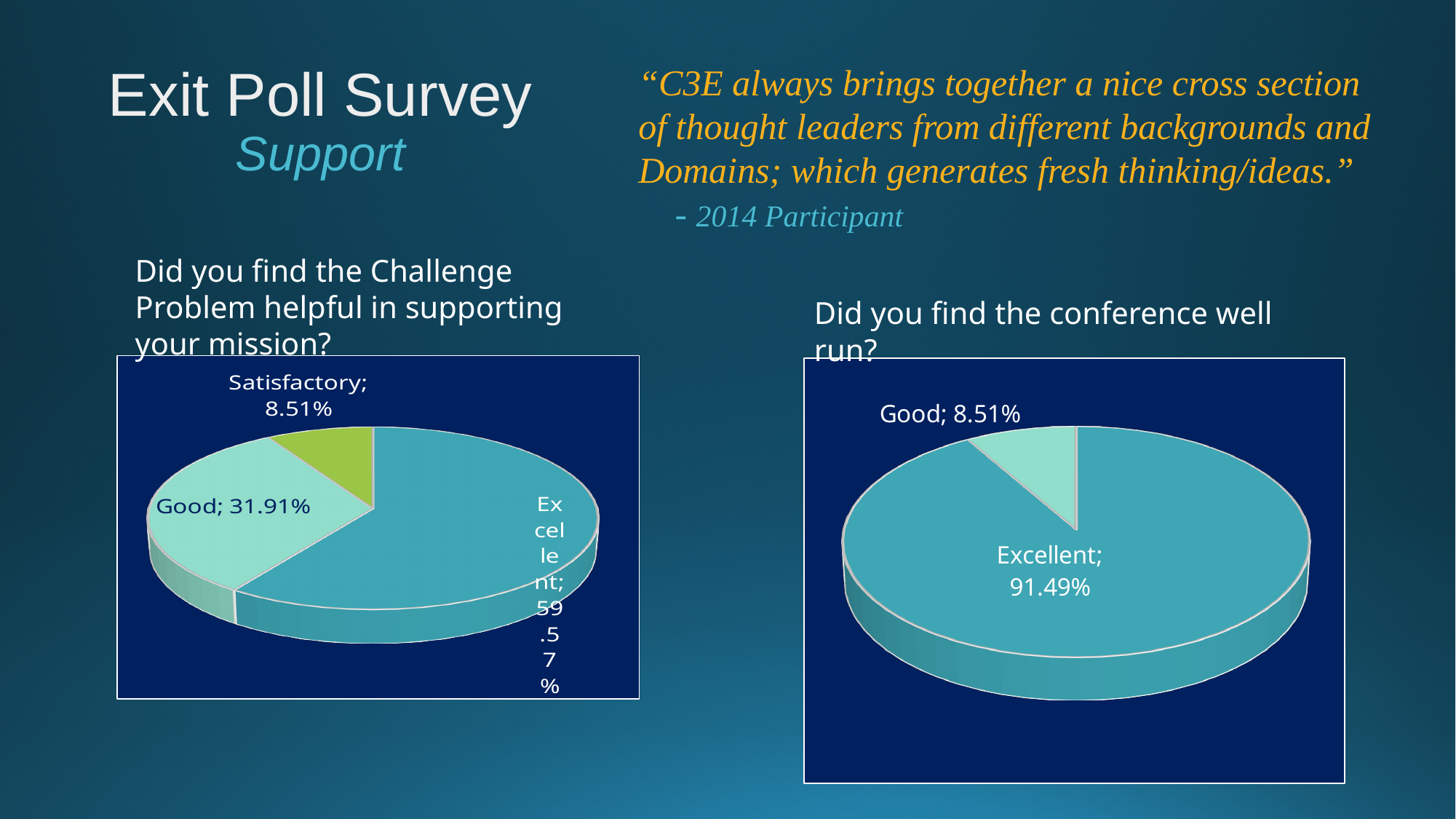
In the left pie chart (Challenge Problem helpful in supporting your mission), which category has the smallest slice? Satisfactory How many slices does the left pie chart (Challenge Problem helpful in supporting your mission) have? 3 In the right pie chart (conference well run), what share is labelled Good? 8.51% In the left pie chart (Challenge Problem helpful in supporting your mission), what share is labelled Excellent? 59.57% In the left pie chart (Challenge Problem helpful in supporting your mission), what share is labelled Good? 31.91% In the right pie chart (conference well run), what share is labelled Excellent? 91.49% In the left pie chart (Challenge Problem helpful in supporting your mission), what is the difference between the Good and Satisfactory shares? 23.40% In the left pie chart (Challenge Problem helpful in supporting your mission), which category has the largest slice? Excellent In the right pie chart (conference well run), which category has the smallest slice? Good In the left pie chart (Challenge Problem helpful in supporting your mission), what share is labelled Satisfactory? 8.51% In the right pie chart (conference well run), what is the difference between the Excellent and Good shares? 82.98% What type of chart is used for the question 'Did you find the conference well run?' Pie chart